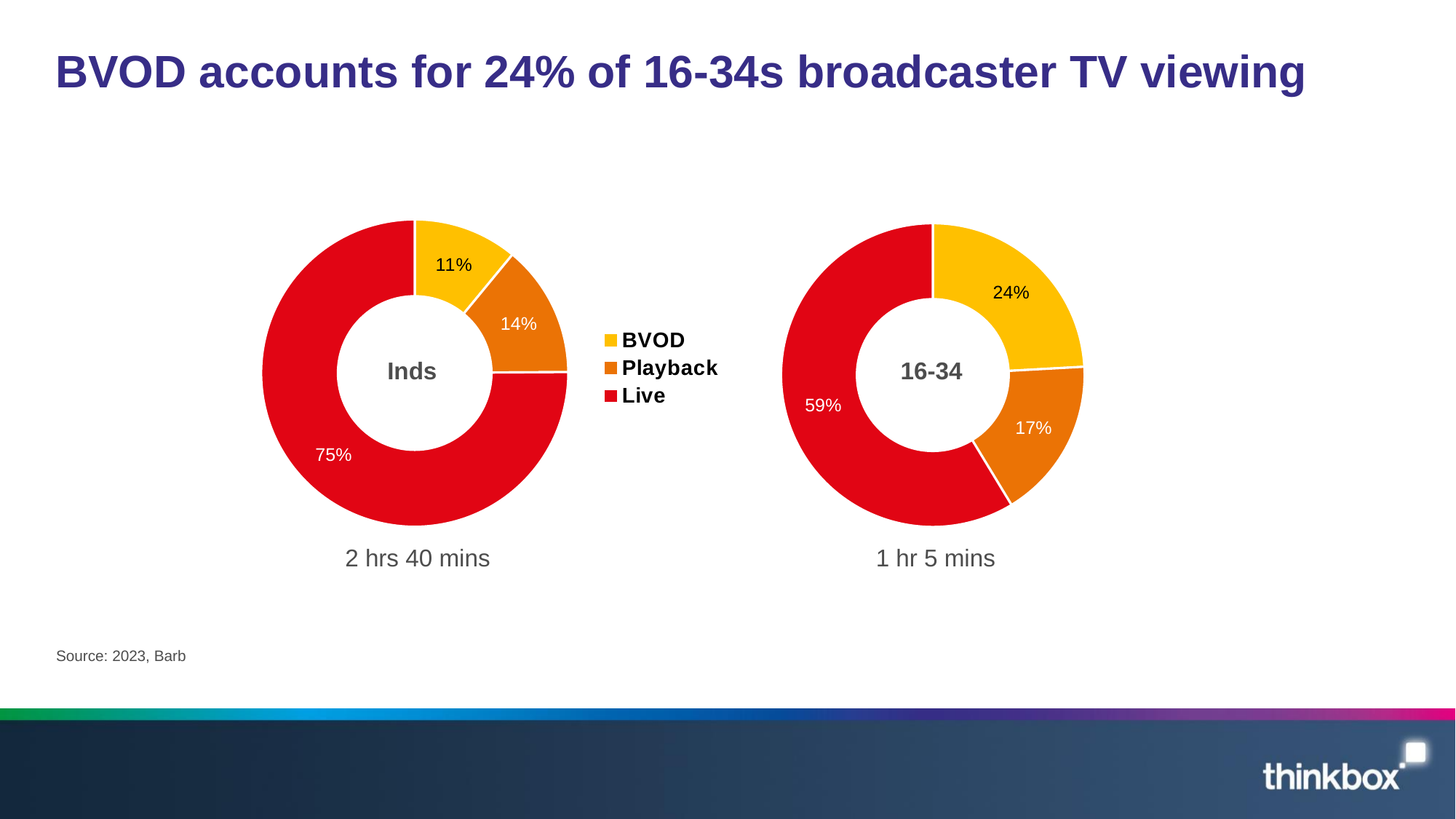
In the 16-34 donut chart, what share of viewing is Live? 59% What is the difference between the Live share in the Inds chart and the Live share in the 16-34 chart? 16 percentage points In the Inds donut chart, which category has the largest share? Live What type of chart is used on this slide? Donut (pie) chart In the 16-34 donut chart, which category has the smallest share? Playback In the Inds donut chart, what share of viewing is BVOD? 11% In the Inds donut chart, which category has the smallest share? BVOD What total viewing time is shown beneath the 16-34 donut chart? 1 hr 5 mins In the 16-34 donut chart, what share of viewing is Playback? 17% How many entries does the legend list? 3 Is the BVOD share larger in the Inds chart or the 16-34 chart? 16-34 How many categories does each donut chart show? 3